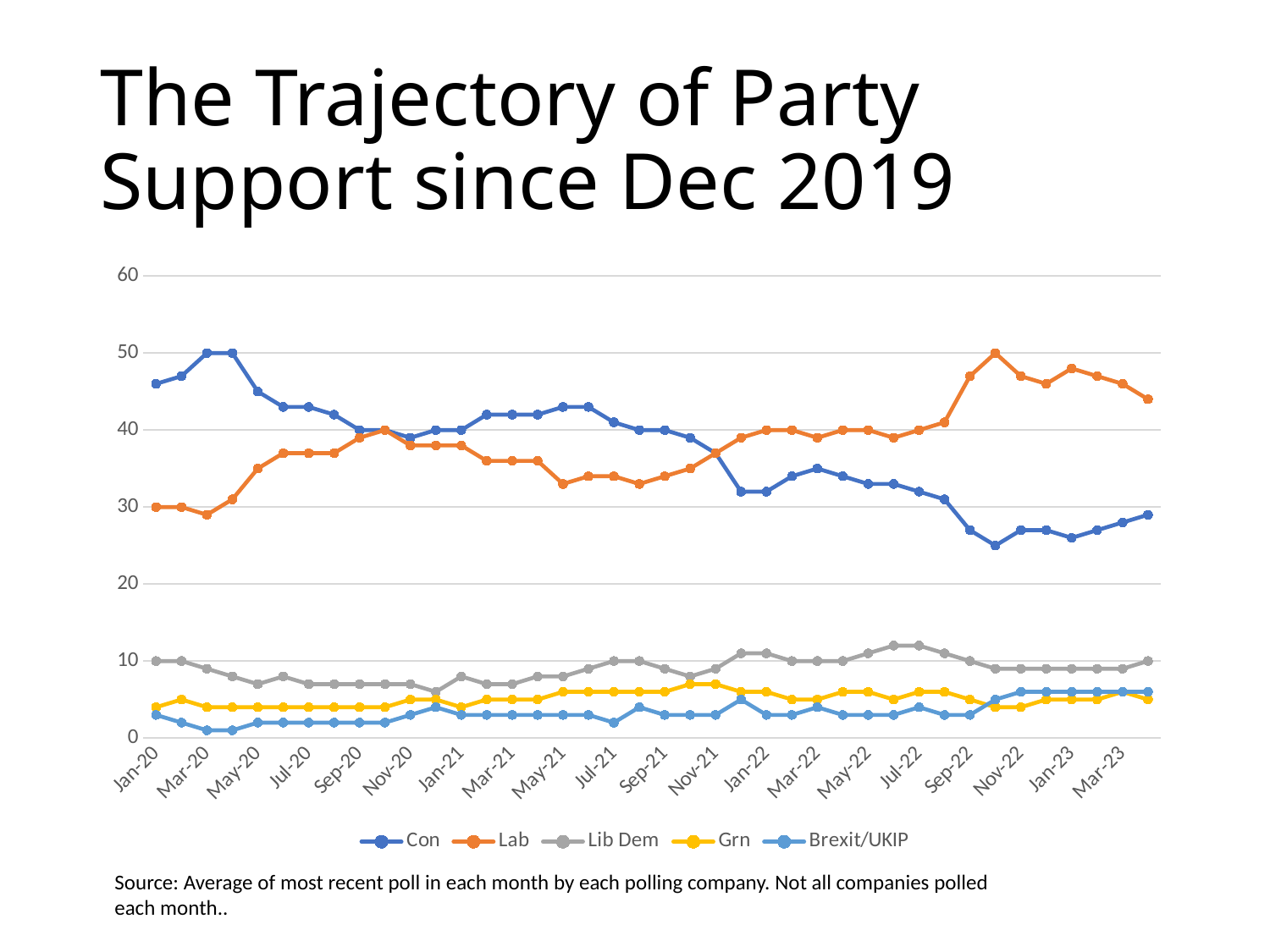
Is the value for Con in Jan-20 greater or less than 40? greater Is the value for Con in Nov-22 greater or less than 30? less How many series does the legend list? 5 Is the value for Lab in Jan-20 greater or less than 40? less Which series has the highest value in Jan-20? Con Which series has the lowest value in Mar-20? Brexit/UKIP Which series are listed in the legend? Con, Lab, Lib Dem, Grn, Brexit/UKIP Which series has the highest value in Mar-23? Lab What kind of chart is shown on the slide? line chart What is the title of the chart on the slide? The Trajectory of Party Support since Dec 2019 Does the Con series rise or fall overall from Jan-20 to Mar-23? fall